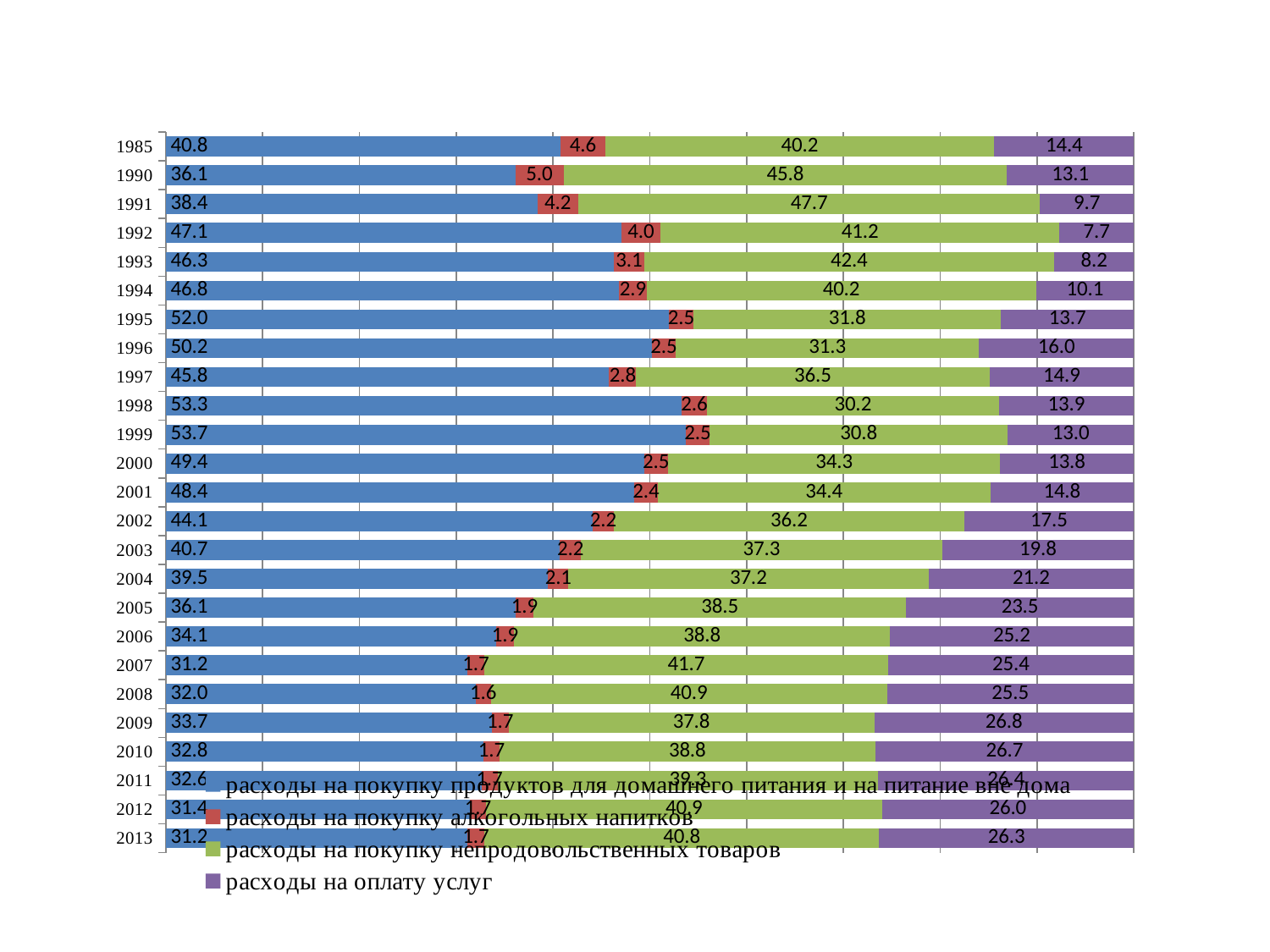
What is the value for 'расходы на оплату услуг' in 2013? 26.3 Which year has the larger value for 'расходы на покупку непродовольственных товаров', 1991 or 2013? 1991 What is the value for 'расходы на покупку алкогольных напитков' in 1990? 5.0 In which year is the value for 'расходы на покупку алкогольных напитков' the lowest? 2008 How many series does the legend list? 4 What is the total of the stacked bar for 1985? 100.0 How many years (categories) are plotted on the chart? 25 What is the difference between the 'расходы на оплату услуг' values for 2013 and 1985? 11.9 In which year is the value for 'расходы на покупку продуктов для домашнего питания и на питание вне дома' the highest? 1999 What is the value for 'расходы на покупку продуктов для домашнего питания и на питание вне дома' in 1995? 52.0 In which year is the value for 'расходы на оплату услуг' the highest? 2009 What kind of chart is shown on the slide? stacked bar chart